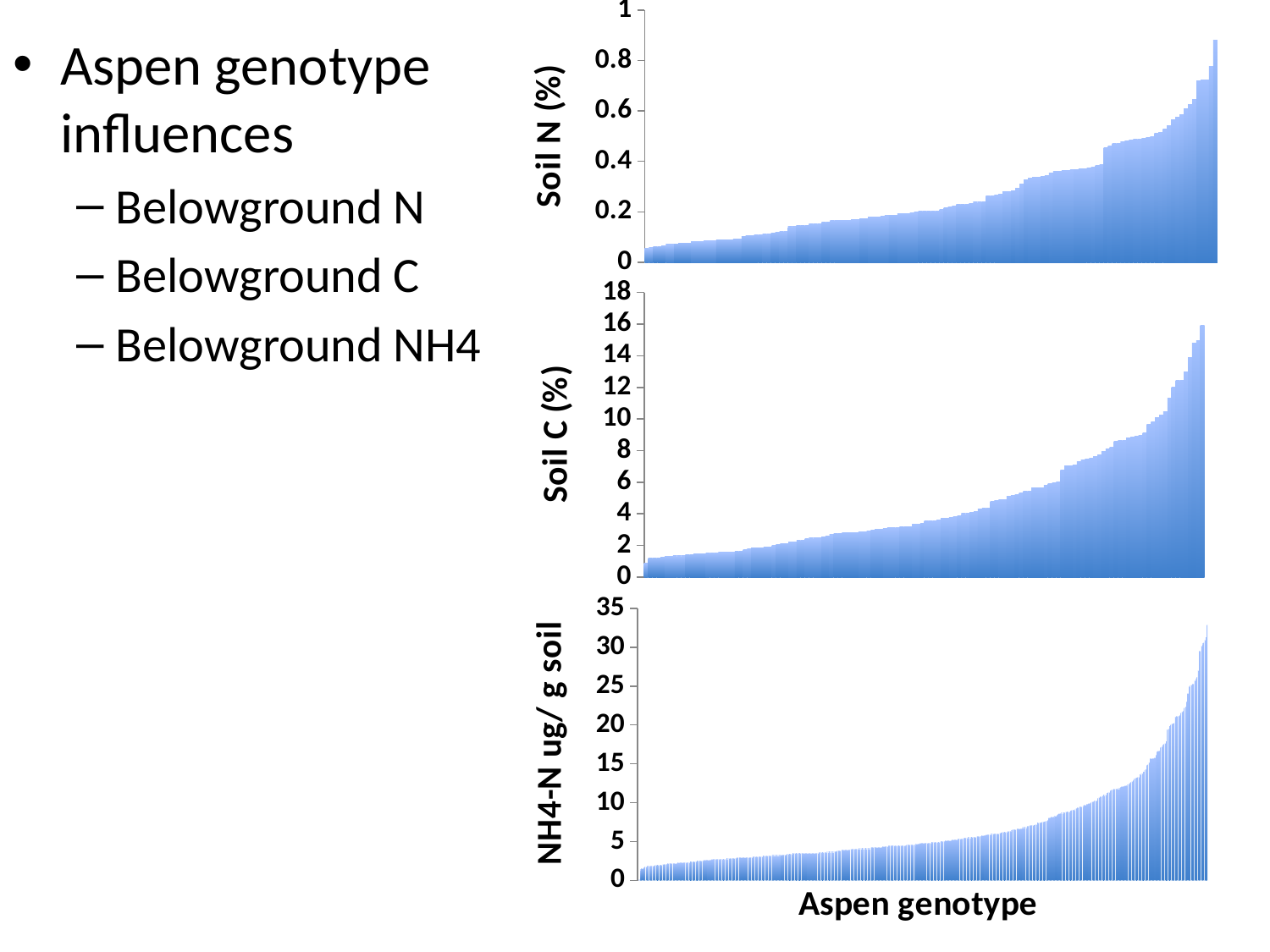
In the bottom chart (NH4-N ug/ g soil), is the value of the tallest bar greater or less than 30? greater In the bottom chart (NH4-N ug/ g soil), is the value of the leftmost bar greater or less than 5? less What is the x-axis label shown beneath the bottom chart? Aspen genotype In the middle chart (Soil C (%)), do the bar values rise or fall from left to right along the x axis? rise In the top chart (Soil N (%)), is the value of the tallest bar greater or less than 0.8? greater What is the y-axis label of the middle chart? Soil C (%) In the top chart (Soil N (%)), do the bar values rise or fall from left to right along the x axis? rise What kind of chart is the bottom chart (NH4-N ug/ g soil)? bar chart In the bottom chart (NH4-N ug/ g soil), do the bar values rise or fall from left to right along the x axis? rise What kind of chart is the top chart (Soil N (%))? bar chart